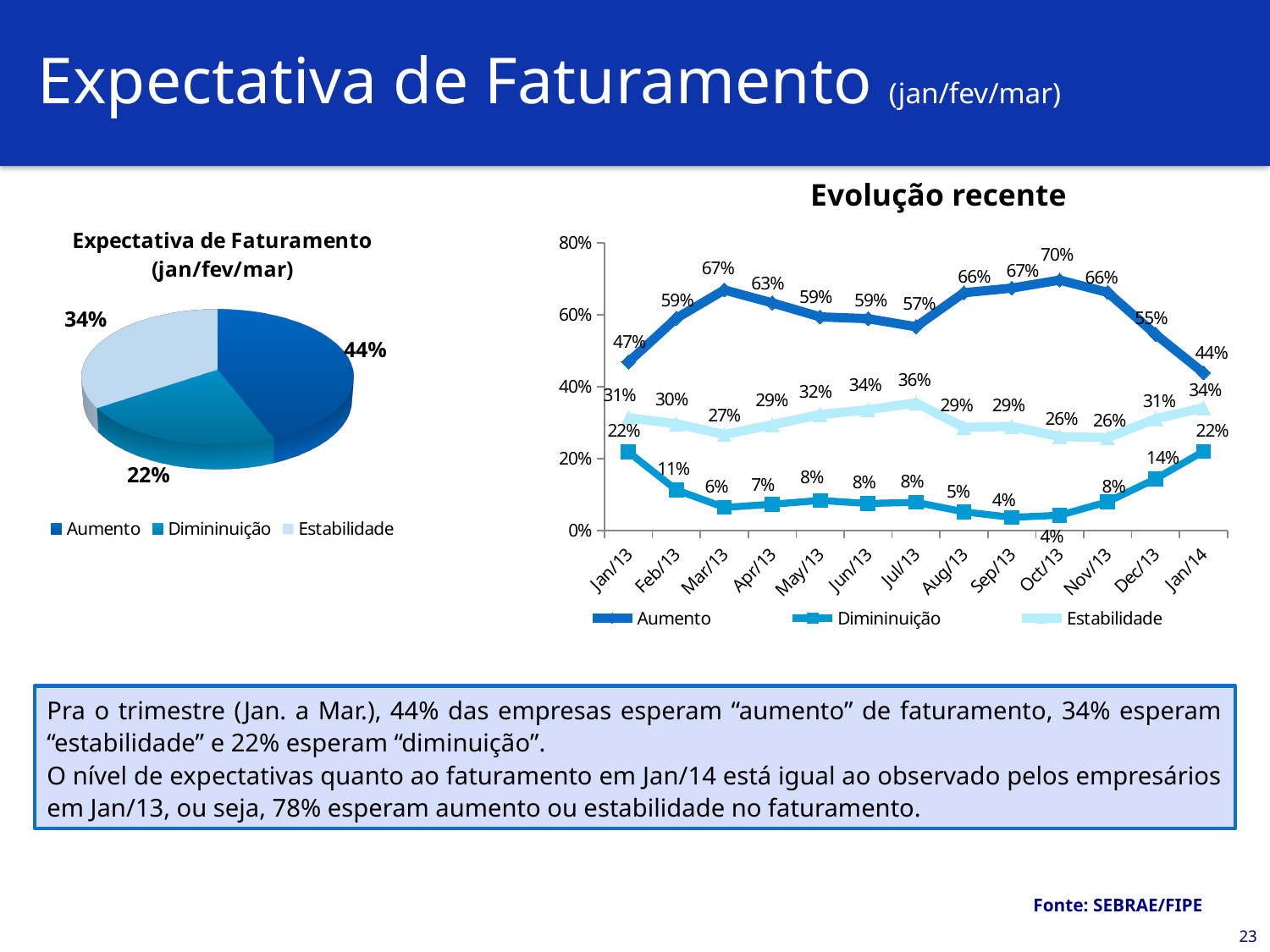
In the 'Evolução recente' chart, how many months are plotted on the x axis? 13 In the pie chart 'Expectativa de Faturamento (jan/fev/mar)', what share of companies expect 'Aumento'? 44% In the 'Evolução recente' chart, does the Aumento series rise or fall from Oct/13 to Jan/14? Fall In the 'Evolução recente' chart, which is larger in Jan/13: Estabilidade or Diminuição? Estabilidade In the 'Evolução recente' chart, what is the value for Aumento in Oct/13? 70% In the 'Evolução recente' chart, what is the difference between the Aumento values in Oct/13 and Jan/14? 26% What kind of chart is 'Evolução recente'? Line chart In the 'Evolução recente' chart, in which month does the Aumento series reach its highest value? Oct/13 In the pie chart 'Expectativa de Faturamento (jan/fev/mar)', which category has the smallest slice? Diminuição In the 'Evolução recente' chart, what is the value for Diminuição in Dec/13? 14% In the 'Evolução recente' chart, what is the value for Estabilidade in Jul/13? 36% In the pie chart 'Expectativa de Faturamento (jan/fev/mar)', how many categories does the legend list? 3